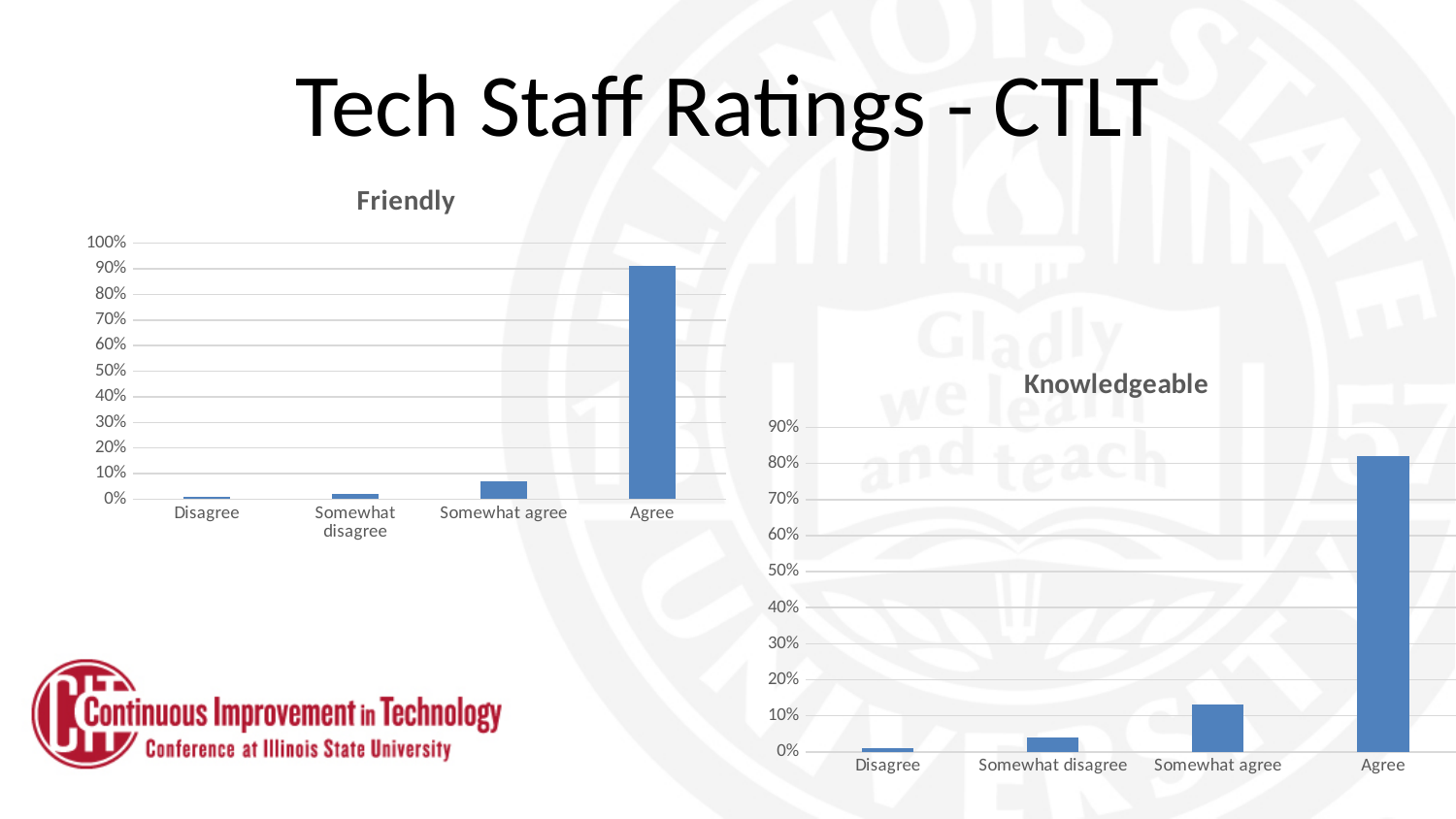
In the "Knowledgeable" chart, which category has the highest value? Agree In the "Knowledgeable" chart, is the value for Somewhat agree greater or less than 10%? greater What is the title of the chart on the left side of the slide? Friendly What kind of chart is the "Friendly" chart? bar chart In the "Knowledgeable" chart, which is larger, the value for Somewhat agree or the value for Agree? Agree In the "Knowledgeable" chart, which category has the lowest value? Disagree In the "Friendly" chart, do the values rise or fall moving from Disagree to Agree along the x axis? rise In the "Friendly" chart, which category has the highest value? Agree How many categories are shown on the x axis of the "Knowledgeable" chart? 4 In the "Knowledgeable" chart, is the value for Agree greater or less than 70%? greater In the "Friendly" chart, is the value for Somewhat agree greater or less than 10%? less